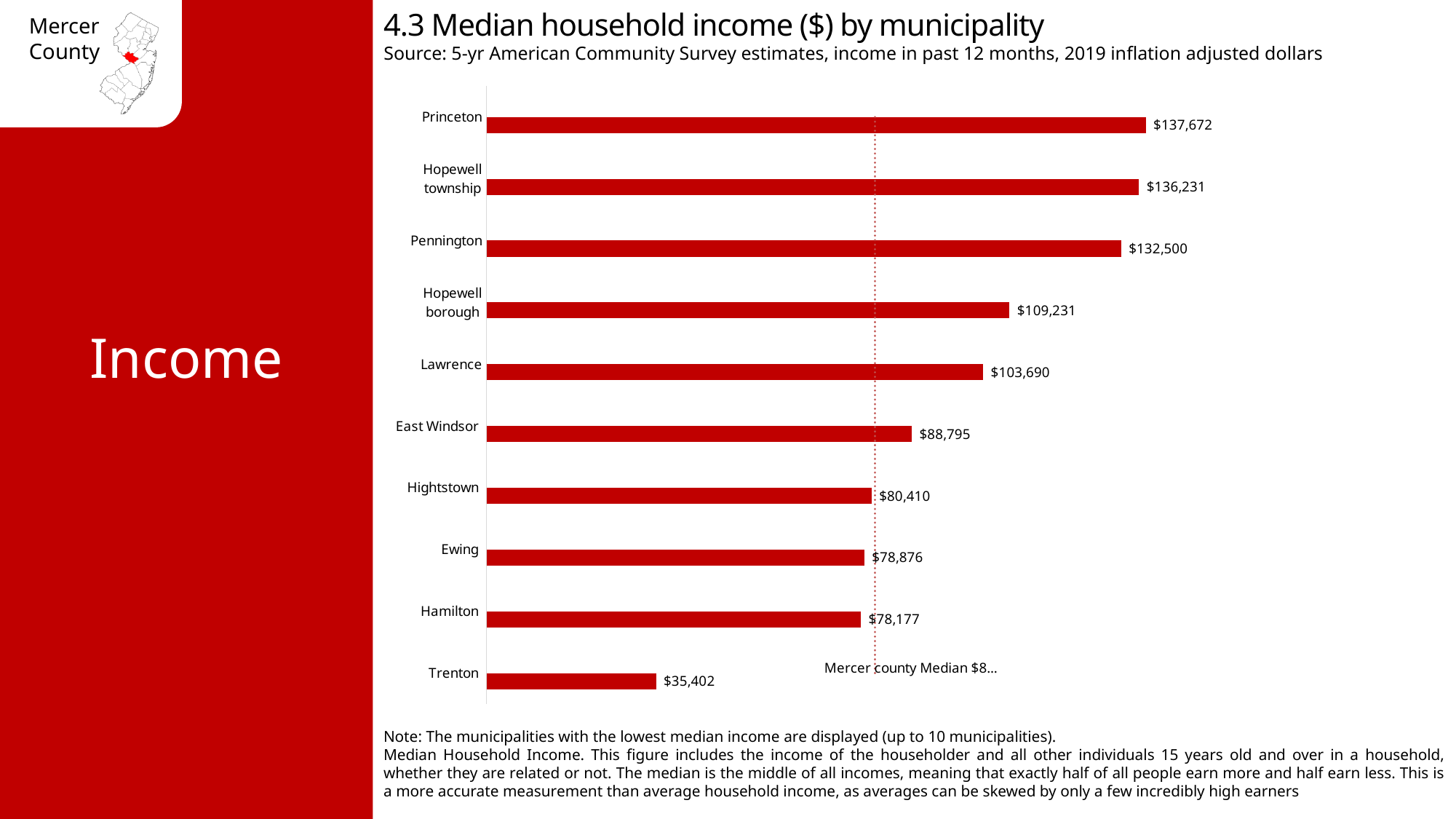
Which has a higher median household income, Ewing or Hightstown? Hightstown What kind of chart is shown on the slide? Bar chart What is the median household income for Hopewell borough? $109,231 What is the median household income for Lawrence? $103,690 What is the difference in median household income between Princeton and Trenton? $102,270 What is the difference in median household income between Pennington and East Windsor? $43,705 Which municipality has the highest median household income? Princeton What is the median household income for Princeton? $137,672 Which municipality has the lowest median household income? Trenton What is the title of the chart? 4.3 Median household income ($) by municipality How many municipalities are shown in the chart? 10 What is the median household income for Trenton? $35,402